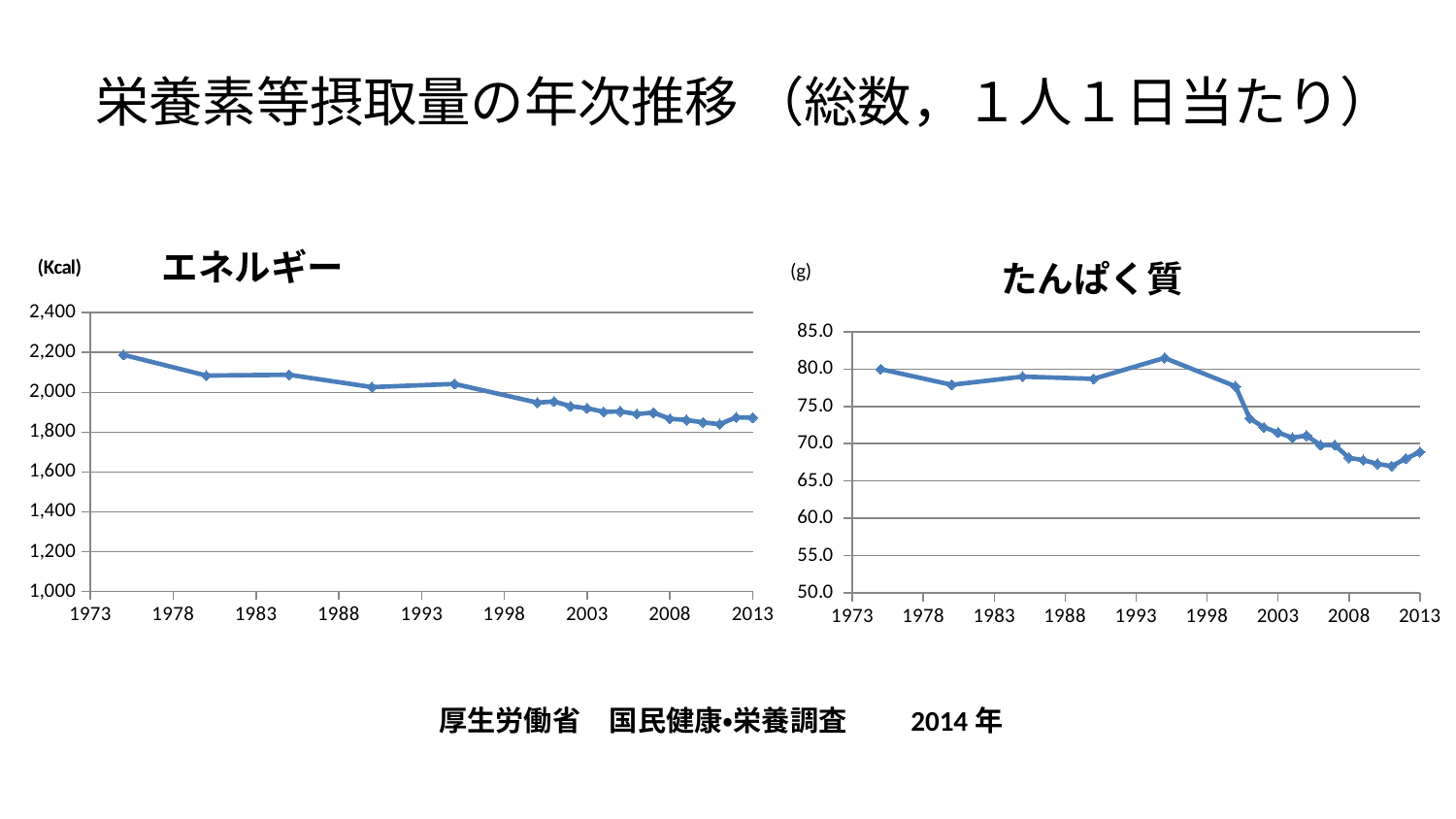
In the エネルギー chart, is the value for 1975 greater or less than 2,000? greater In the エネルギー chart, which year has the highest value? 1975 In the たんぱく質 chart, is the value for 2000 greater or less than 75.0? greater In the エネルギー chart, is the value for 2013 greater or less than 2,000? less In the たんぱく質 chart, do the values generally rise or fall from 1973 to 2013? fall What kind of chart is the エネルギー chart on the left? line chart In the エネルギー chart, do the values generally rise or fall from 1973 to 2013? fall What unit is shown on the y axis of the たんぱく質 chart? g What kind of chart is the たんぱく質 chart on the right? line chart In the たんぱく質 chart, which year has the highest value? 1995 In the エネルギー chart, which is larger, the value for 1975 or the value for 2013? 1975